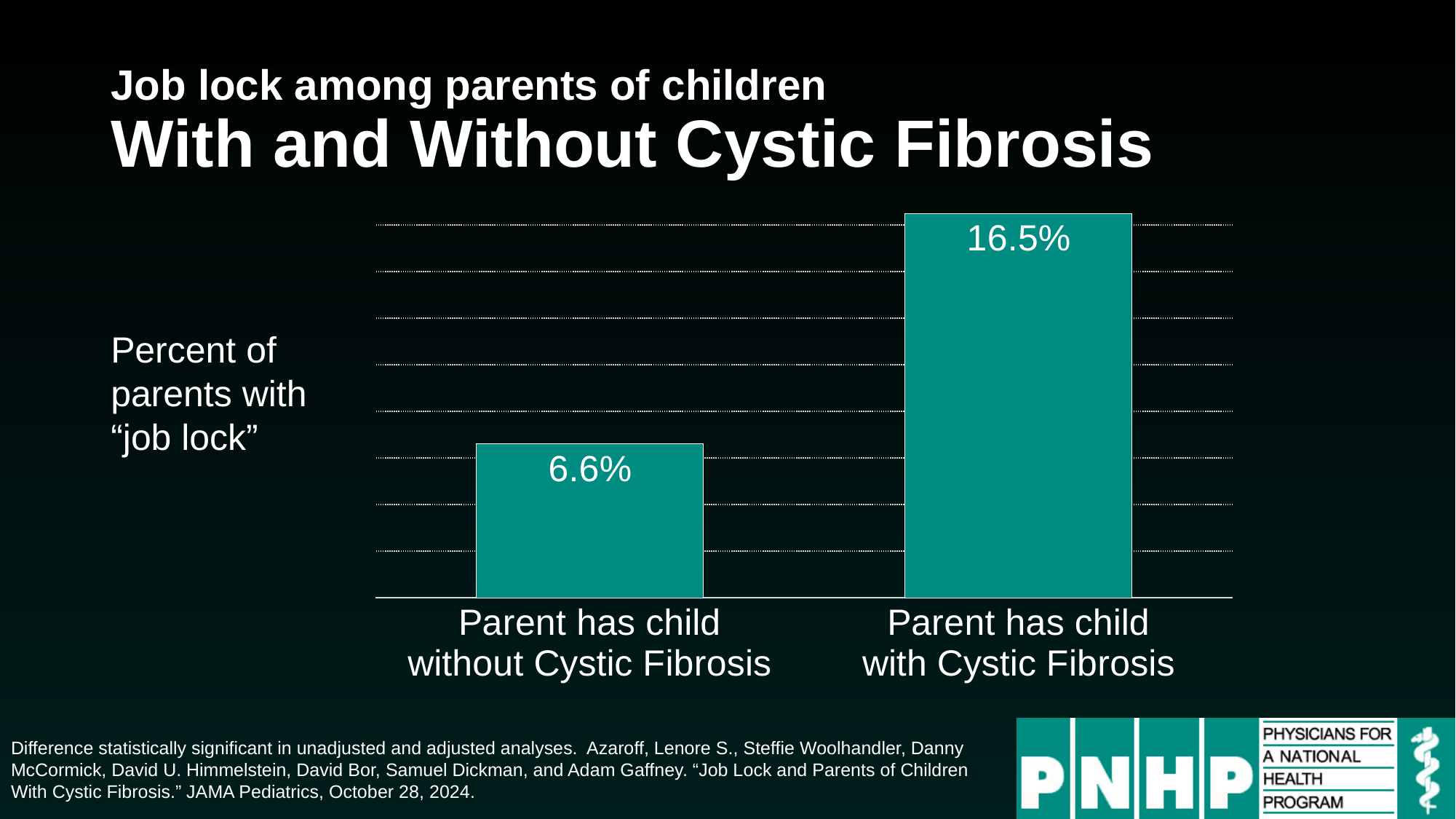
Is the job lock percentage larger for parents of children with Cystic Fibrosis or without Cystic Fibrosis? With Cystic Fibrosis Which group has the lower percent of parents with job lock? Parent has child without Cystic Fibrosis What does the vertical axis of the chart measure, according to the label on the left? Percent of parents with "job lock" How many categories are shown in the chart? 2 What kind of chart is shown on the slide? Bar chart What percent of parents with a child without Cystic Fibrosis report job lock? 6.6% Which group has the higher percent of parents with job lock? Parent has child with Cystic Fibrosis What is the difference in job lock percentage between parents of children with and without Cystic Fibrosis? 9.9% What percent of parents with a child with Cystic Fibrosis report job lock? 16.5% What colour are the bars in the chart? Teal